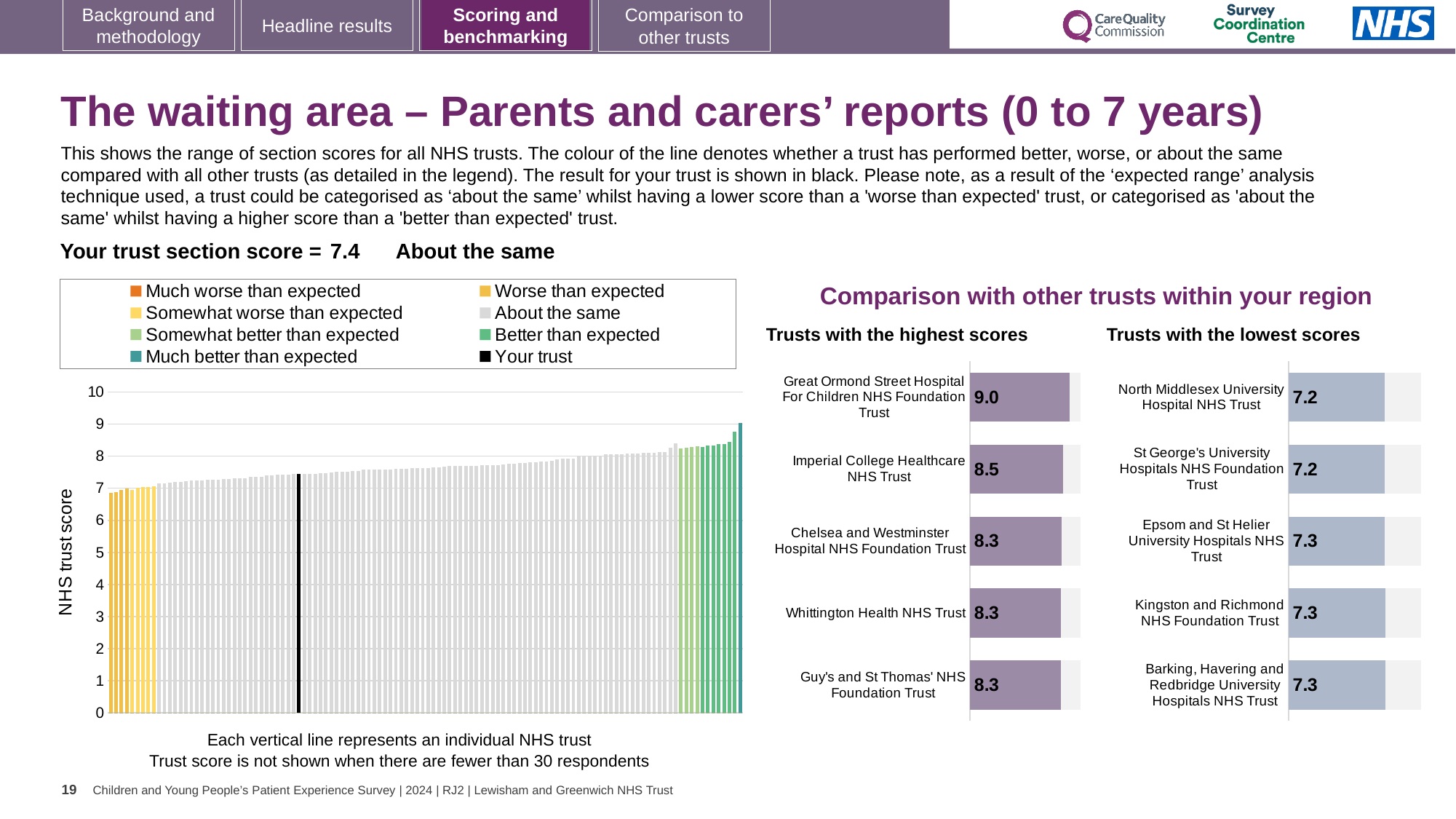
In the 'Trusts with the highest scores' chart, which trust has the highest score? Great Ormond Street Hospital For Children NHS Foundation Trust What kind of chart is the large chart on the left with the y axis labelled 'NHS trust score'? bar chart In the large chart on the left, is the value of the black bar (your trust) greater or less than 8? less In the 'Trusts with the highest scores' chart, what is the difference between the scores of Great Ormond Street Hospital For Children NHS Foundation Trust and Imperial College Healthcare NHS Trust? 0.5 In the large chart on the left, what is the label on the y axis? NHS trust score In the 'Trusts with the highest scores' chart, how many trusts are shown? 5 In the large chart on the left, is the value of the tallest bar greater or less than 8? greater In the 'Trusts with the lowest scores' chart, what is the score for Epsom and St Helier University Hospitals NHS Trust? 7.3 Which is larger: the score for Imperial College Healthcare NHS Trust in the 'Trusts with the highest scores' chart or the score for Kingston and Richmond NHS Foundation Trust in the 'Trusts with the lowest scores' chart? Imperial College Healthcare NHS Trust In the 'Trusts with the highest scores' chart, what is the score for Great Ormond Street Hospital For Children NHS Foundation Trust? 9.0 In the 'Trusts with the lowest scores' chart, what is the score for North Middlesex University Hospital NHS Trust? 7.2 In the large chart on the left, how many entries does the legend list? 8